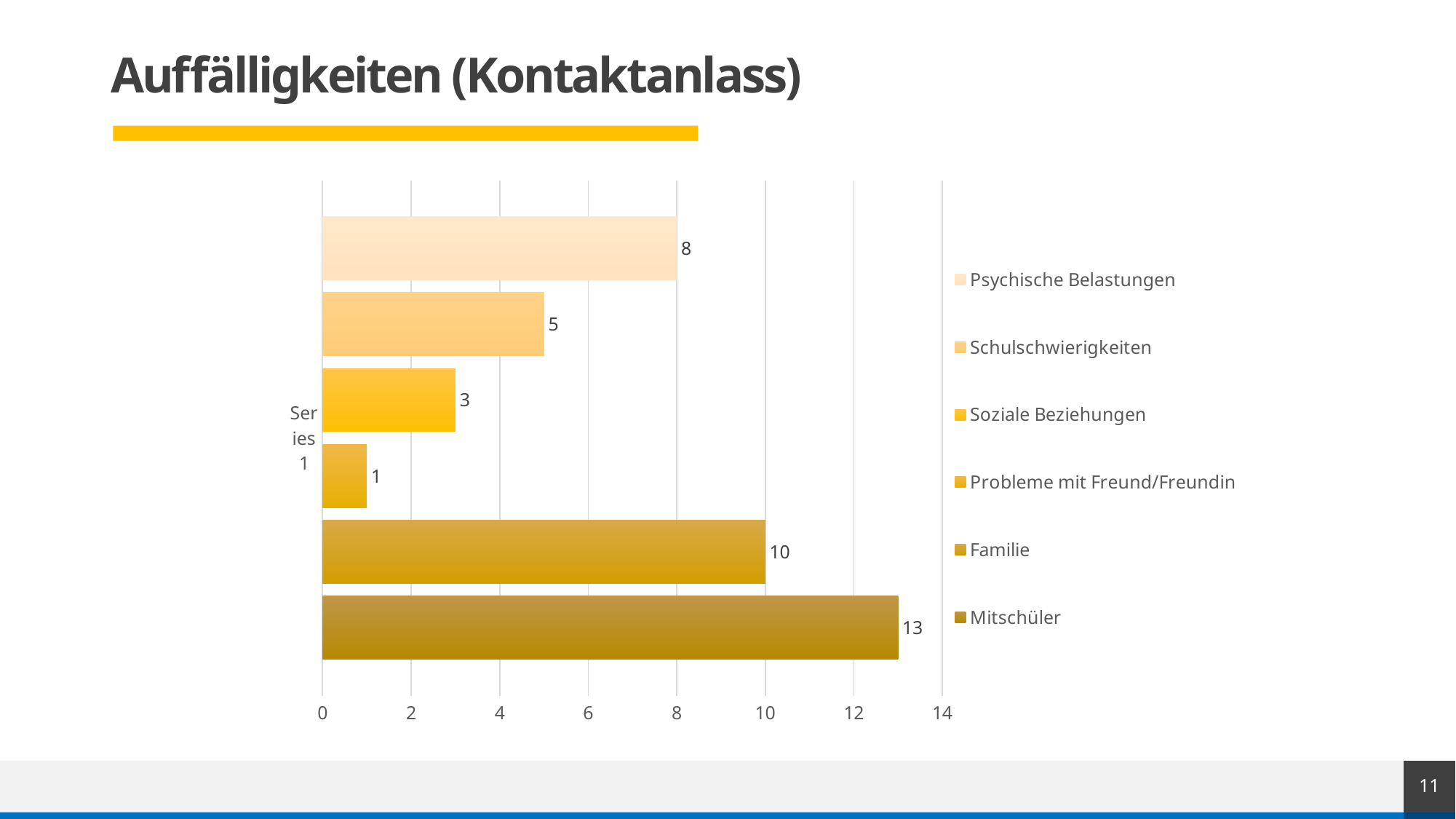
Which is larger, the value for Schulschwierigkeiten or the value for Soziale Beziehungen? Schulschwierigkeiten Which legend entry has the highest value? Mitschüler What is the value for Psychische Belastungen? 8 What is the value for Familie? 10 How many series does the legend list? 6 What kind of chart is shown on the slide? bar chart What is the title of the slide? Auffälligkeiten (Kontaktanlass) What is the value for Probleme mit Freund/Freundin? 1 What is the value for Mitschüler? 13 What is the difference between the values for Mitschüler and Familie? 3 Which legend entry has the lowest value? Probleme mit Freund/Freundin What is the difference between the values for Psychische Belastungen and Schulschwierigkeiten? 3